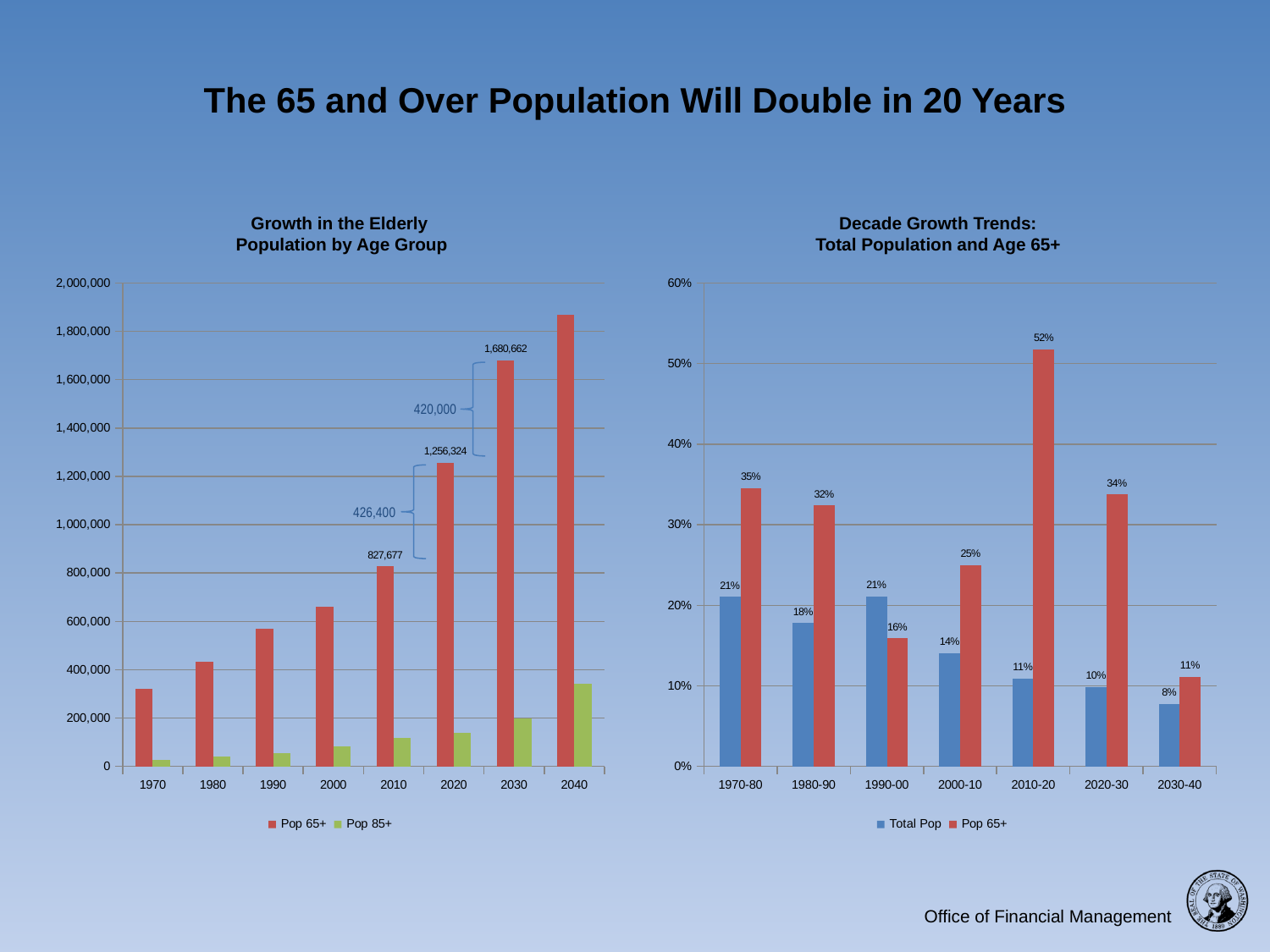
In the 'Growth in the Elderly Population by Age Group' chart, what is the difference between the Pop 65+ values for 2030 and 2020? 424,338 In the 'Growth in the Elderly Population by Age Group' chart, is the Pop 65+ value for 2040 greater or less than 1,800,000? greater In the 'Growth in the Elderly Population by Age Group' chart, what is the Pop 65+ value for 2030? 1,680,662 What kind of chart is the 'Decade Growth Trends: Total Population and Age 65+' chart? bar chart In the 'Decade Growth Trends: Total Population and Age 65+' chart, what is the Total Pop value for 2030-40? 8% In the 'Growth in the Elderly Population by Age Group' chart, does the Pop 65+ series rise or fall from 1970 to 2040? rise In the 'Decade Growth Trends: Total Population and Age 65+' chart, what is the difference between the Pop 65+ and Total Pop values for 1970-80? 14% In the 'Growth in the Elderly Population by Age Group' chart, how many series does the legend list? 2 In the 'Decade Growth Trends: Total Population and Age 65+' chart, what is the Pop 65+ value for 2010-20? 52% In the 'Decade Growth Trends: Total Population and Age 65+' chart, which decade has the highest Pop 65+ value? 2010-20 In the 'Decade Growth Trends: Total Population and Age 65+' chart, which decade has the lowest Total Pop value? 2030-40 In the 'Growth in the Elderly Population by Age Group' chart, what is the Pop 65+ value for 2010? 827,677